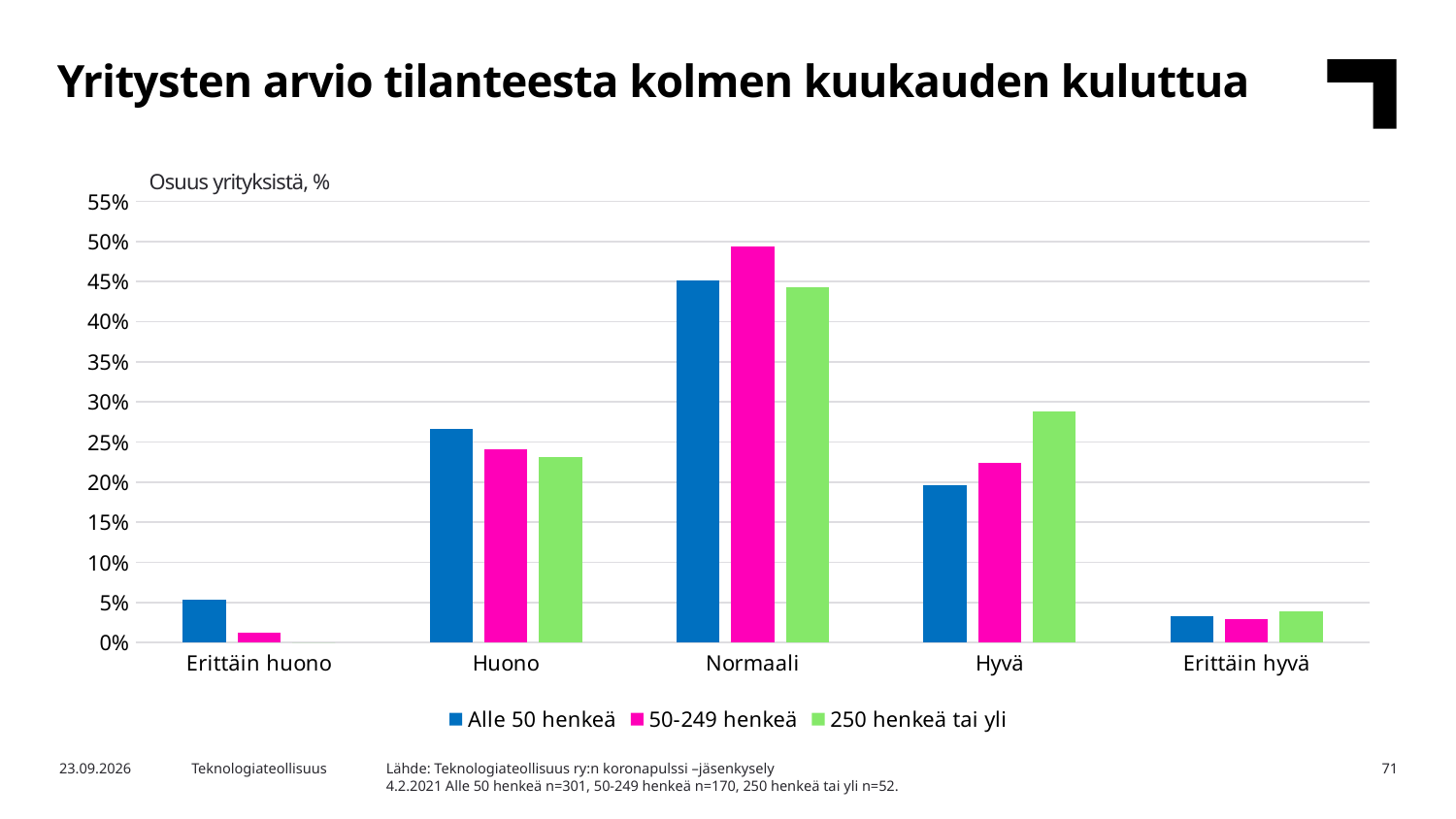
How many categories are shown on the x axis? 5 Which category has the highest value for the 50-249 henkeä series? Normaali What kind of chart is shown on the slide? bar chart How many series does the legend list? 3 Is the value for Alle 50 henkeä in the Erittäin huono category greater or less than 10%? less Is the value for Alle 50 henkeä in the Normaali category greater or less than 40%? greater In the Hyvä category, which is larger: Alle 50 henkeä or 250 henkeä tai yli? 250 henkeä tai yli Which series has the highest value in the Normaali category? 50-249 henkeä Which category has the lowest value for the Alle 50 henkeä series? Erittäin hyvä In the Huono category, which is larger: Alle 50 henkeä or 250 henkeä tai yli? Alle 50 henkeä Is the value for 250 henkeä tai yli in the Hyvä category greater or less than 25%? greater What is the label shown above the vertical axis? Osuus yrityksistä, %